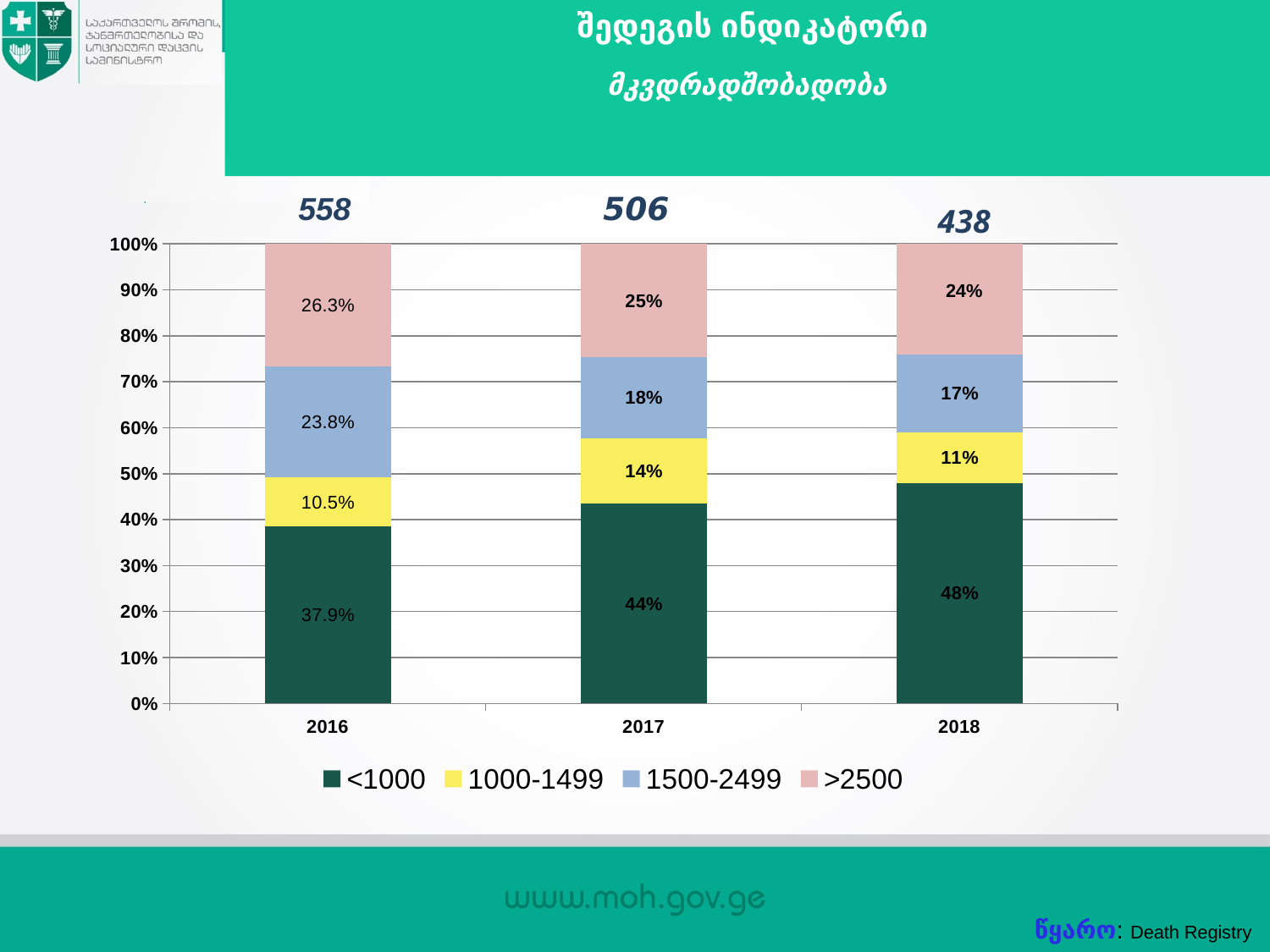
What is the value for the >2500 series in 2018? 24% What kind of chart is shown on the slide? Stacked bar chart How many series does the legend list? 4 What number is printed above the 2017 bar? 506 Which is larger: the 1000-1499 share in 2017 or in 2018? 2017 Which year has the lowest number printed above its bar? 2018 What is the difference between the numbers printed above the 2016 and 2018 bars? 120 What is the value for the <1000 series in 2016? 37.9% How many years are shown on the x axis? 3 What is the value for the 1500-2499 series in 2017? 18% Does the share of the >2500 series rise or fall from 2016 to 2018? Fall Which year has the highest share for the <1000 series? 2018